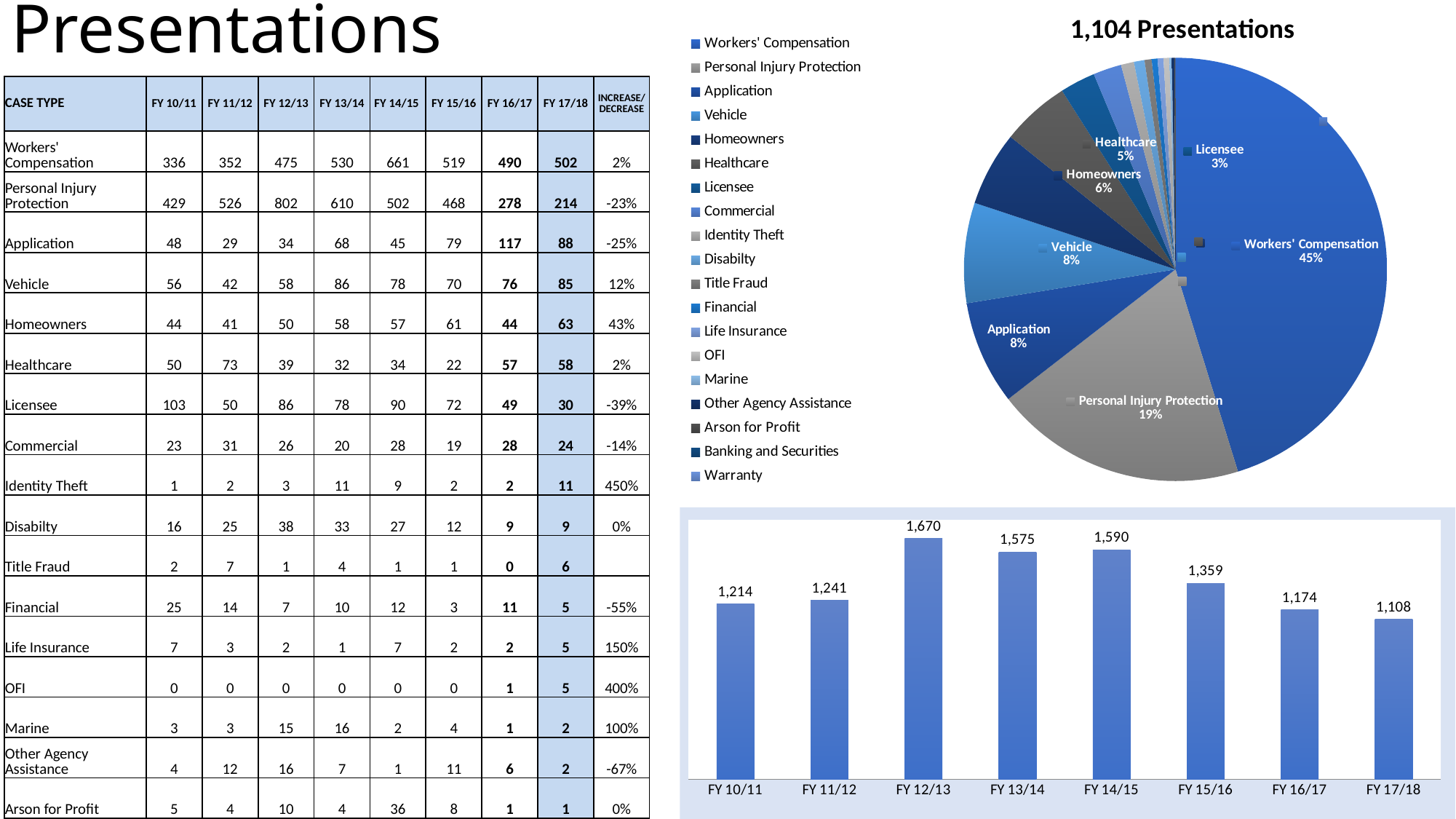
In the bar chart at the bottom right, what is the value for FY 12/13? 1,670 In the bar chart at the bottom right, what is the value for FY 17/18? 1,108 In the bar chart at the bottom right, which is larger, the value for FY 15/16 or the value for FY 16/17? FY 15/16 In the pie chart titled '1,104 Presentations', what share does Workers' Compensation have? 45% In the bar chart at the bottom right, which fiscal year has the highest value? FY 12/13 How many bars are in the bar chart at the bottom right? 8 How many entries does the legend of the pie chart titled '1,104 Presentations' list? 19 In the pie chart titled '1,104 Presentations', what share does Personal Injury Protection have? 19% In the bar chart at the bottom right, which fiscal year has the lowest value? FY 17/18 In the bar chart at the bottom right, what is the difference between the FY 12/13 value and the FY 17/18 value? 562 What kind of chart is the chart at the bottom right of the slide? bar chart In the bar chart at the bottom right, do the values rise or fall from FY 14/15 to FY 17/18? fall